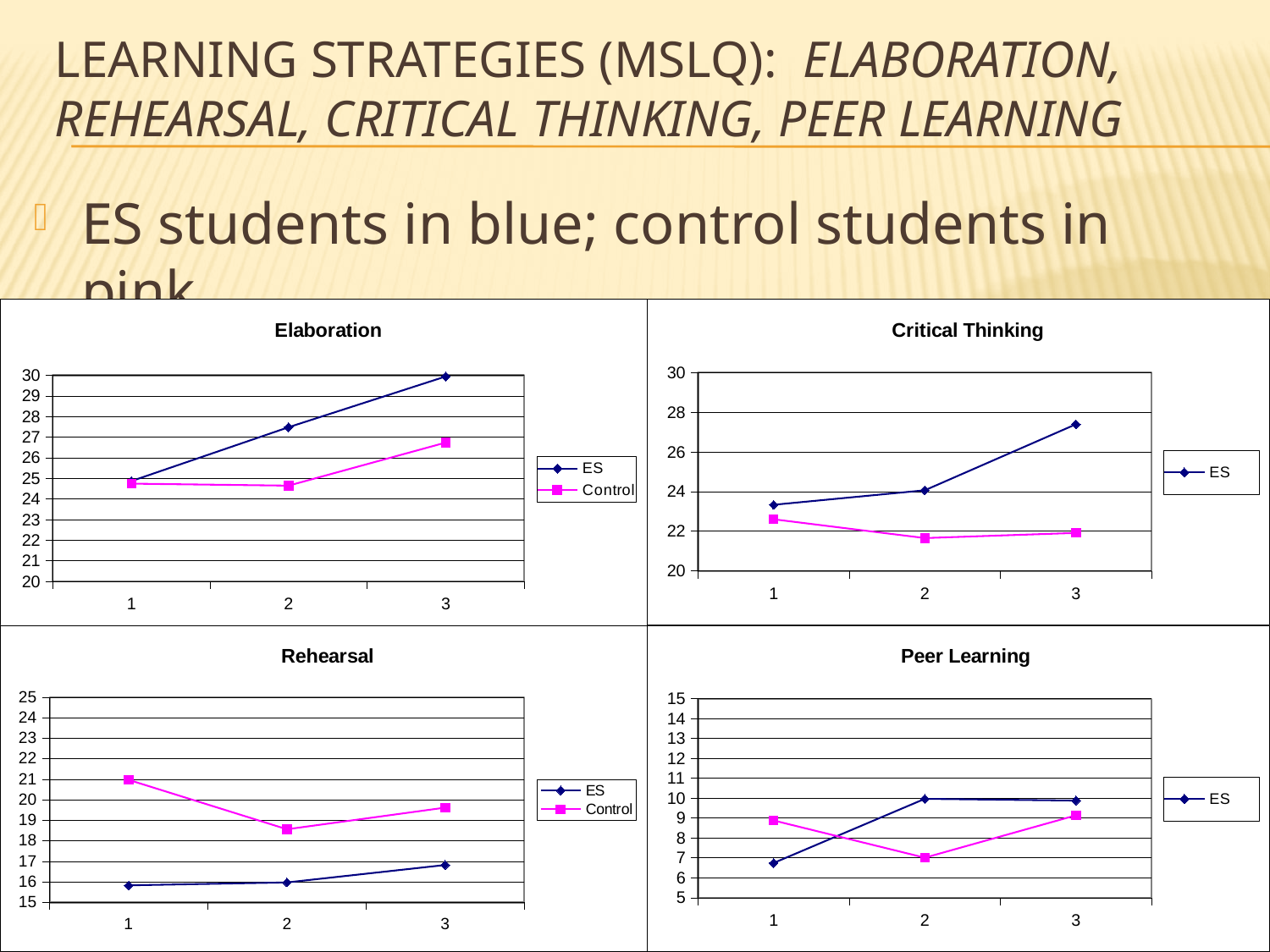
In the Rehearsal chart, is the ES value at point 1 greater or less than 17? less How many points are plotted along the x axis in the Elaboration chart? 3 In the Elaboration chart, is the Control value at point 3 greater or less than 26? greater What kind of chart is the Elaboration chart? line chart In the Elaboration chart, does the ES line rise or fall from point 1 to point 3? rise In the Peer Learning chart, at point 1, which is larger: the blue (ES) line or the pink (Control) line? Control How many series does the legend of the Critical Thinking chart list? 1 In the Critical Thinking chart, at which point is the pink (Control) line lowest? 2 In the Rehearsal chart, at point 1, which is larger: ES or Control? Control How many series does the legend of the Elaboration chart list? 2 In the Critical Thinking chart, at which point is the ES (blue) line highest? 3 In the Peer Learning chart, is the pink (Control) value at point 2 greater or less than 8? less